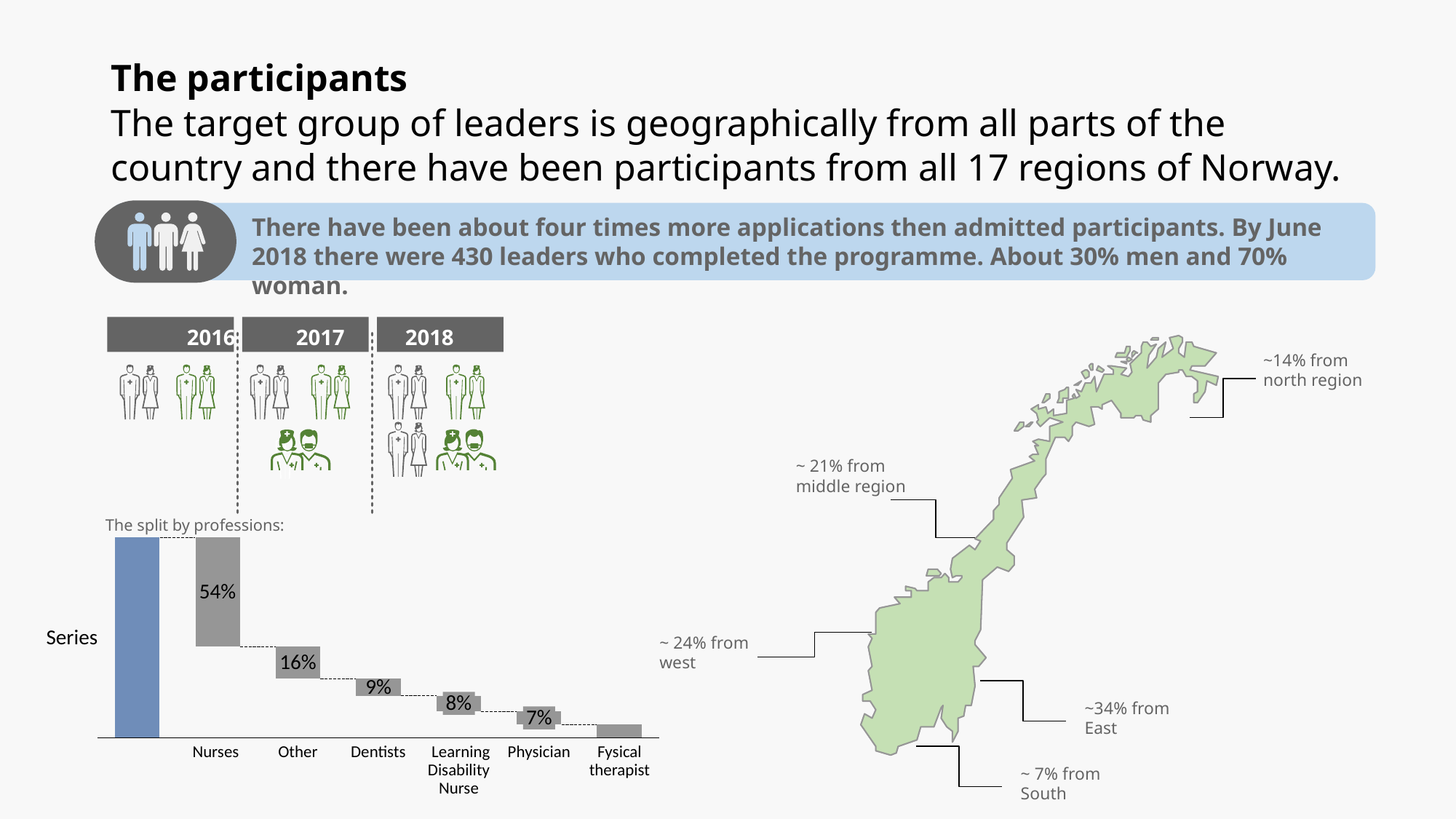
In the chart 'The split by professions', what is the difference between the values for Nurses and Other? 38% In the chart 'The split by professions', which profession has the highest share? Nurses In the chart 'The split by professions', do the values rise or fall from Nurses to Physician along the x axis? fall What kind of chart is 'The split by professions'? bar chart What is the title shown above the bar chart on the left of the slide? The split by professions: In the chart 'The split by professions', what is the value for Dentists? 9% In the chart 'The split by professions', what is the value for Other? 16% In the chart 'The split by professions', what is the value for Learning Disability Nurse? 8% In the chart 'The split by professions', what is the value for Physician? 7% In the chart 'The split by professions', how many profession categories are labelled on the x axis? 6 In the chart 'The split by professions', which is larger, the value for Dentists or the value for Physician? Dentists In the chart 'The split by professions', what is the value for Nurses? 54%